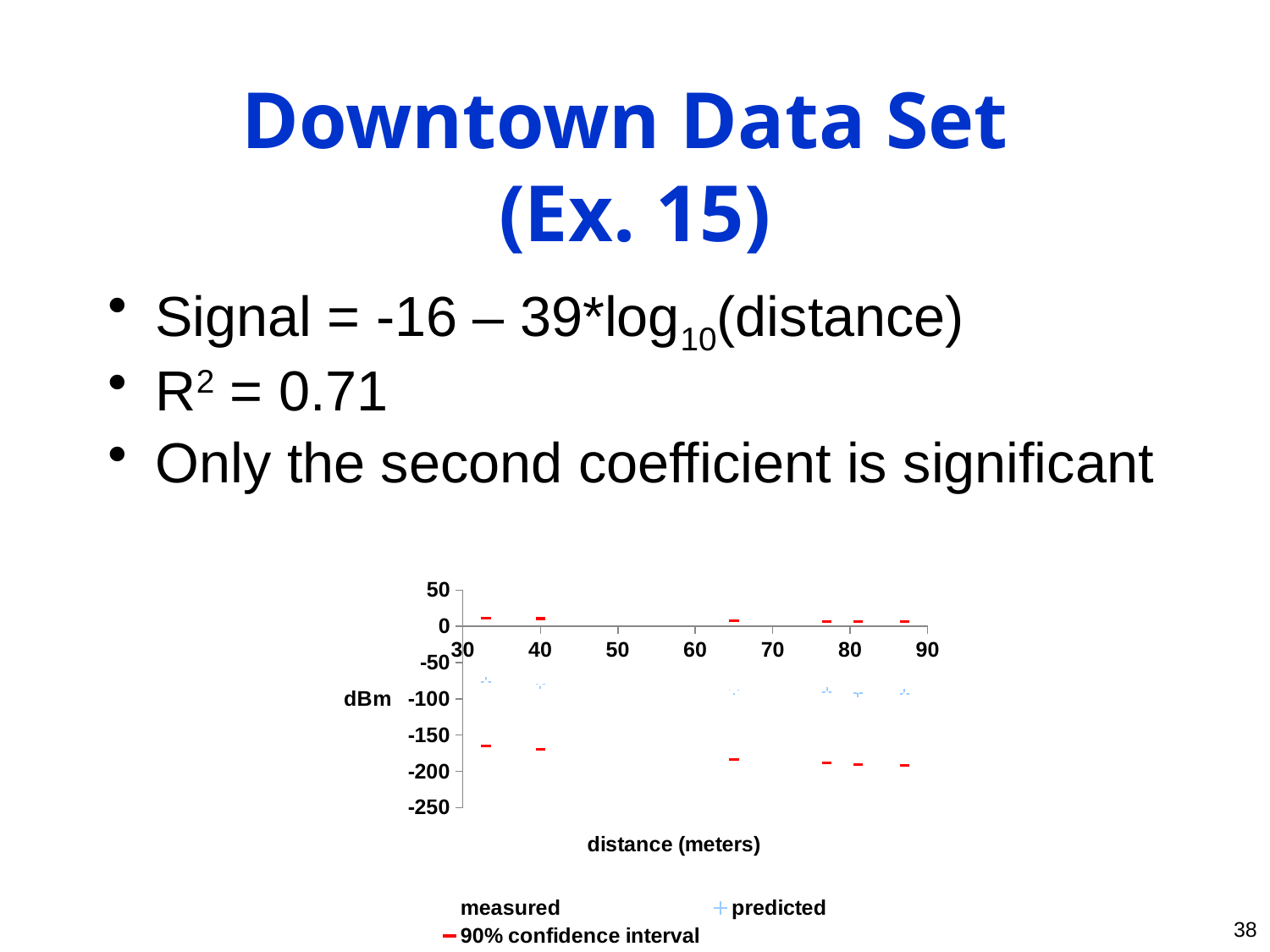
What is the label of the y axis of the chart? dBm What is the label of the x axis of the chart? distance (meters) How many series does the chart legend list? 3 Is the upper 90% confidence interval value at a distance of 40 meters greater or less than 0? greater How many tick labels are shown on the x axis of the chart? 7 What kind of chart is shown on the slide? scatter chart What is the lowest value labelled on the y axis of the chart? -250 Do the predicted values rise or fall as distance increases along the x axis? fall